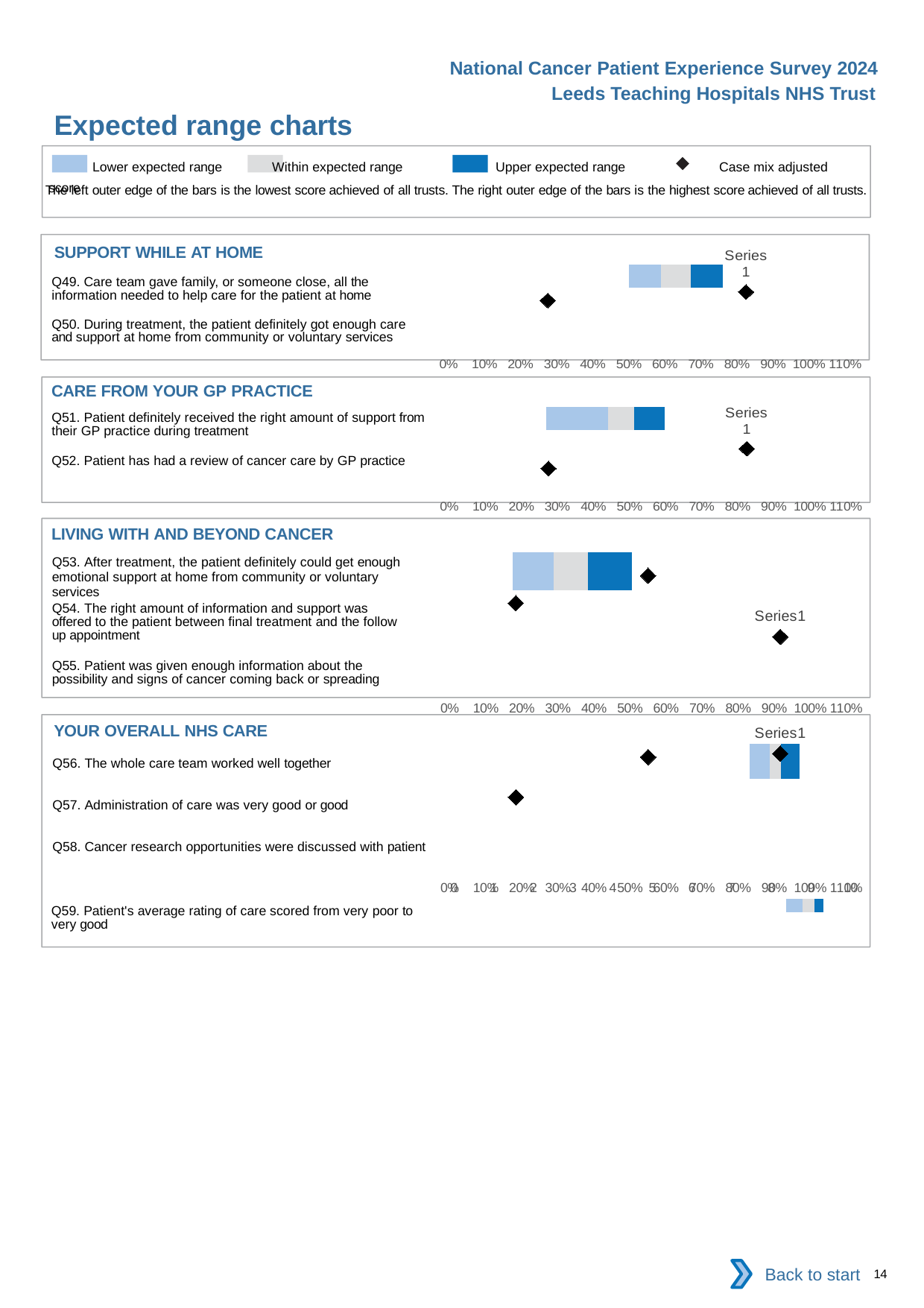
What is the highest value shown on the x axis of the CARE FROM YOUR GP PRACTICE chart? 110% How many expected range chart sections are shown on the slide? 4 According to the legend, what does the diamond marker represent? Case mix adjusted score What kind of chart is used in the SUPPORT WHILE AT HOME section? bar chart How many questions are listed in the SUPPORT WHILE AT HOME chart? 2 In the LIVING WITH AND BEYOND CANCER chart, is the case mix adjusted score for Q53 greater or less than 40%? greater How many entries does the legend at the top of the slide list? 4 How many questions are listed in the CARE FROM YOUR GP PRACTICE chart? 2